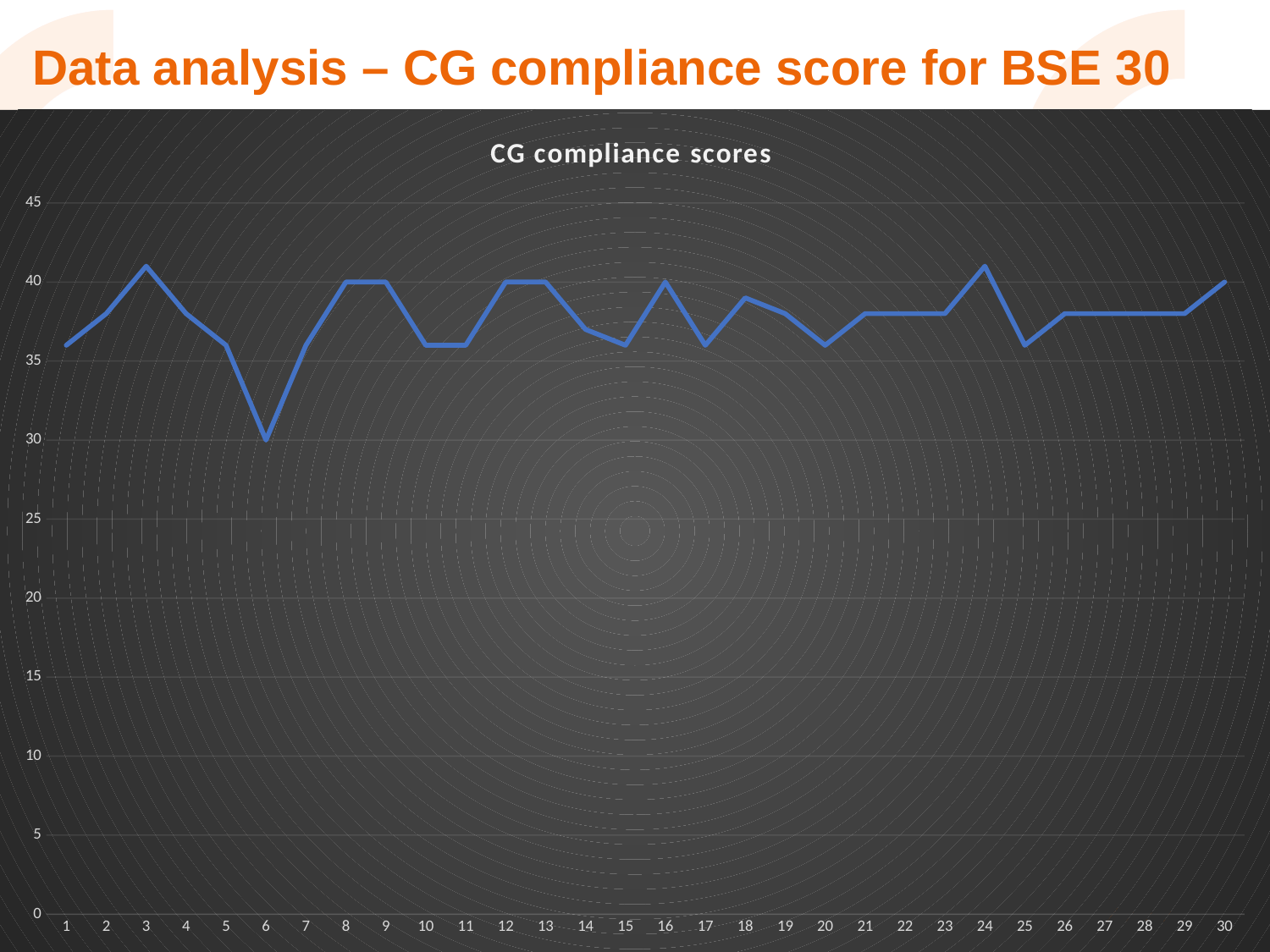
What kind of chart is shown on the slide? line chart What is the difference between the scores at point 8 and point 6? 10 How many data points are plotted along the x axis? 30 Which point on the x axis has the lowest CG compliance score? 6 Do the scores rise or fall from point 3 to point 6? fall Is the score at point 6 greater or less than 35? less What is the CG compliance score at point 30? 40 What is the CG compliance score at point 8? 40 What is the title of the chart? CG compliance scores Which has the higher score, point 3 or point 6? point 3 Is the score at point 18 greater or less than 35? greater What is the CG compliance score at point 6? 30